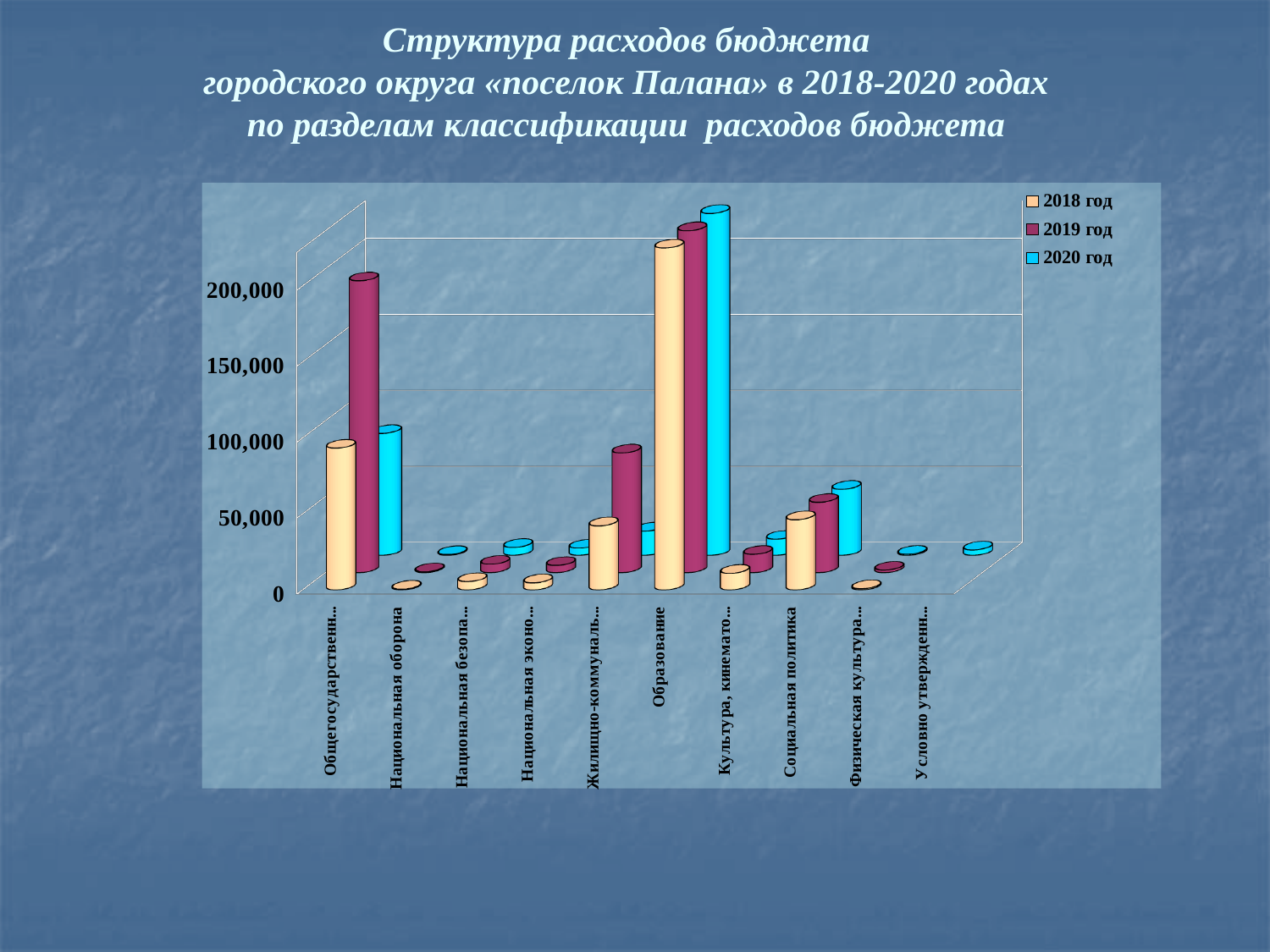
How many series does the legend list? 3 Is the value for Национальная оборона in 2018 год greater or less than 50,000? less Which category has the highest value for the 2020 год series? Образование Which is larger for 2018 год: Образование or Общегосударственн...? Образование Is the value for Жилищно-коммуналь... in 2019 год greater or less than 50,000? greater What is the highest value labelled on the vertical axis? 200,000 Which series is shown in light blue (cyan) in the legend? 2020 год How many categories are shown on the x axis? 10 Is the value for Образование in 2020 год greater or less than 200,000? greater Which category has the highest value for the 2018 год series? Образование What kind of chart is shown on the slide? bar chart Which is larger for 2020 год: Социальная политика or Культура, кинемато...? Социальная политика